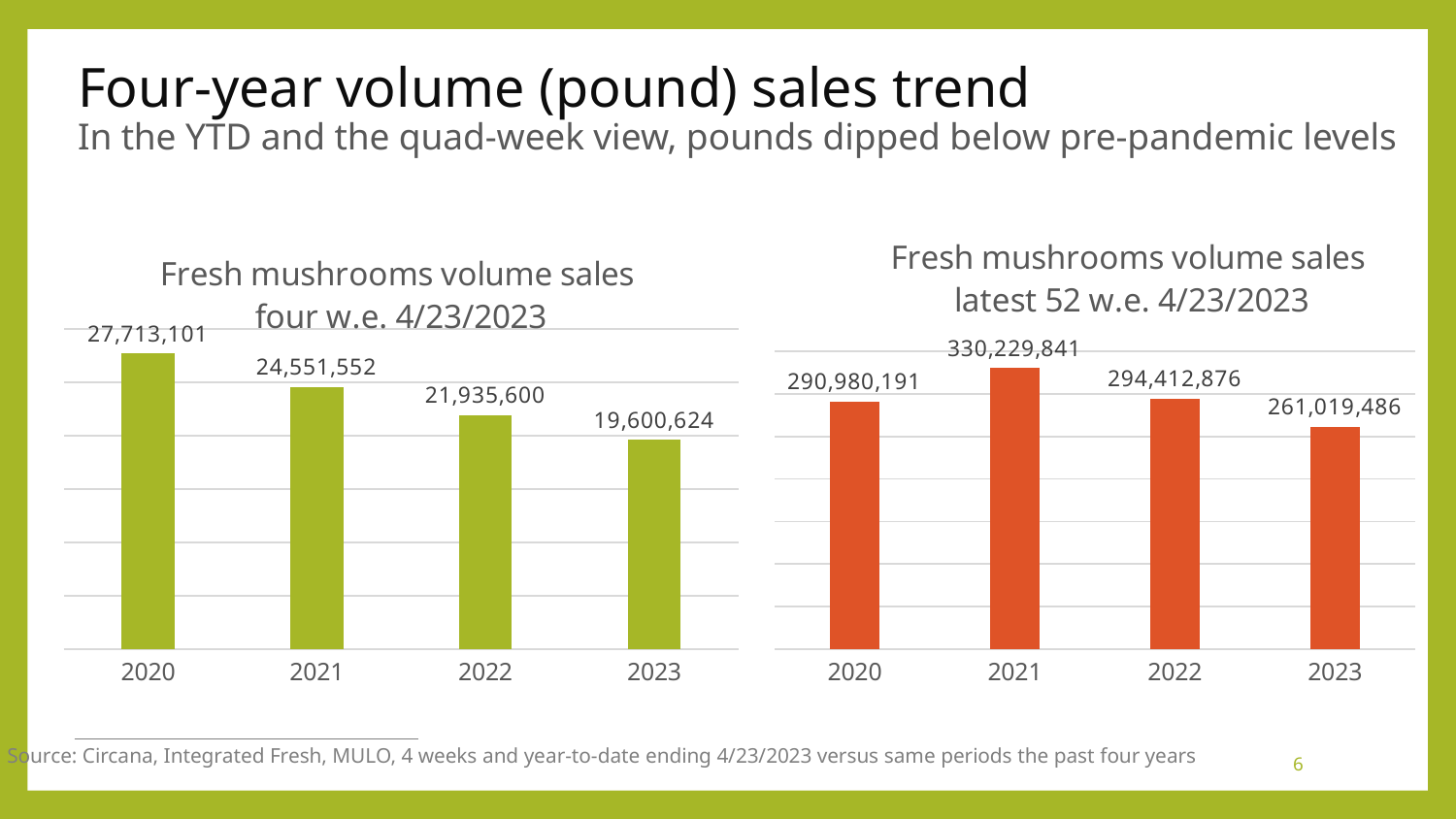
In the 'Fresh mushrooms volume sales latest 52 w.e. 4/23/2023' chart, what is the value for 2022? 294,412,876 How many years are shown in the 'Fresh mushrooms volume sales four w.e. 4/23/2023' chart? 4 In the 'Fresh mushrooms volume sales four w.e. 4/23/2023' chart, what is the value for 2020? 27,713,101 What kind of chart is the 'Fresh mushrooms volume sales latest 52 w.e. 4/23/2023' chart? Bar chart In the 'Fresh mushrooms volume sales latest 52 w.e. 4/23/2023' chart, what is the value for 2021? 330,229,841 In the 'Fresh mushrooms volume sales latest 52 w.e. 4/23/2023' chart, which year has the highest value? 2021 In the 'Fresh mushrooms volume sales four w.e. 4/23/2023' chart, what is the difference between the 2020 and 2023 values? 8,112,477 In the 'Fresh mushrooms volume sales four w.e. 4/23/2023' chart, do the values rise or fall from 2020 to 2023? Fall In the 'Fresh mushrooms volume sales latest 52 w.e. 4/23/2023' chart, what is the difference between the 2021 and 2023 values? 69,210,355 In the 'Fresh mushrooms volume sales four w.e. 4/23/2023' chart, what is the value for 2023? 19,600,624 In the 'Fresh mushrooms volume sales latest 52 w.e. 4/23/2023' chart, which is larger, the value for 2020 or the value for 2023? 2020 In the 'Fresh mushrooms volume sales four w.e. 4/23/2023' chart, which year has the lowest value? 2023